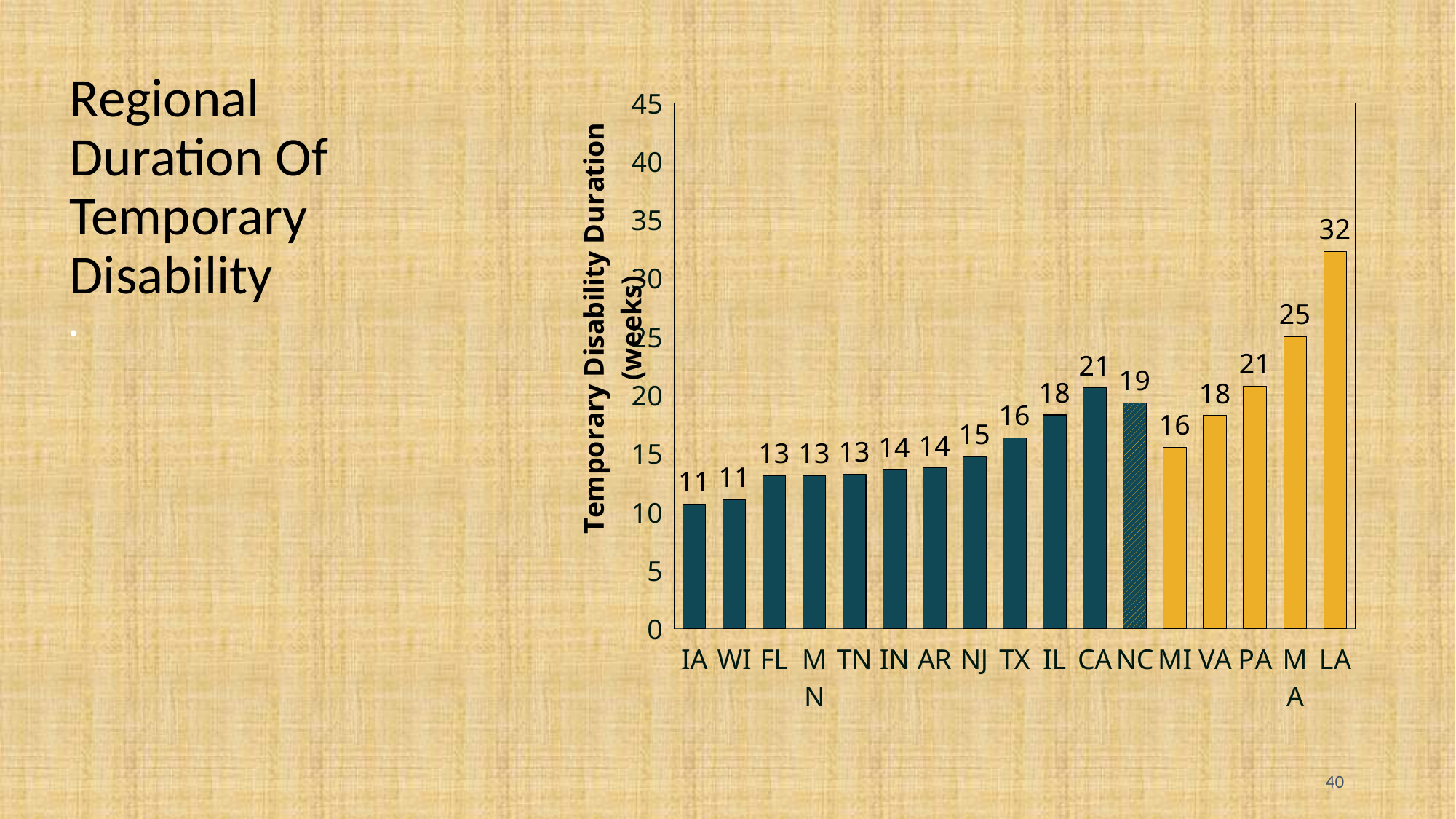
Which has a larger value, CA or NC? CA What is the value shown for MA? 25 What is the value shown for NC? 19 What is the label on the vertical axis of the chart? Temporary Disability Duration (weeks) What is the difference between the values for PA and MI? 5 What is the difference between the values for LA and MA? 7 What kind of chart is shown on the slide? Bar chart What is the temporary disability duration for LA? 32 How many states are shown on the x axis of the chart? 17 Which state has the highest temporary disability duration? LA Which has a larger value, IL or TX? IL What is the value shown for CA? 21